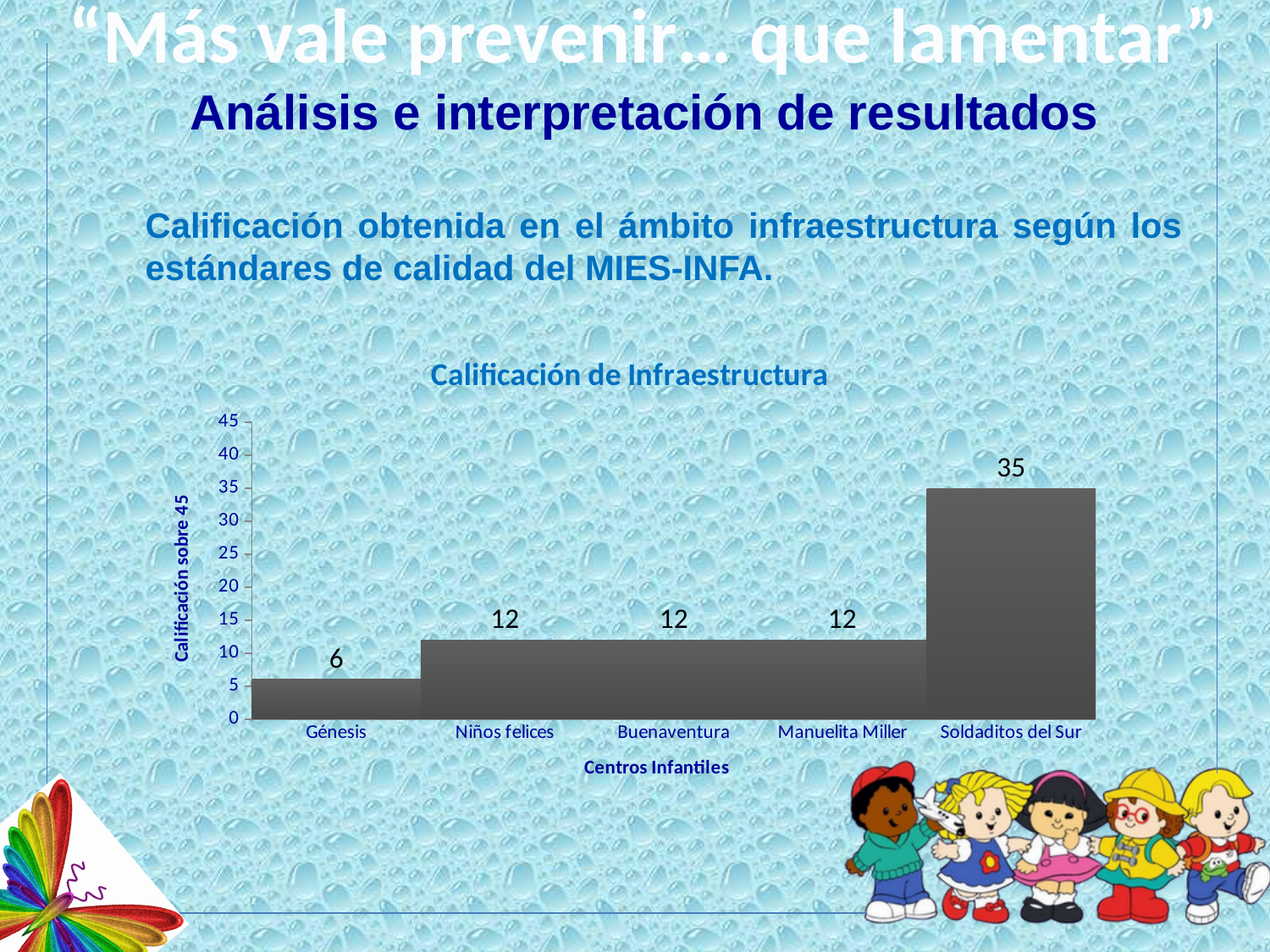
What is the value for Génesis? 6 How many centros infantiles are shown on the x axis? 5 Which is larger, the value for Manuelita Miller or the value for Génesis? Manuelita Miller What is the title of the chart? Calificación de Infraestructura What is the difference between the values for Niños felices and Génesis? 6 Which centro infantil has the lowest calificación? Génesis What is the value for Soldaditos del Sur? 35 Which centro infantil has the highest calificación? Soldaditos del Sur Is the value for Soldaditos del Sur greater or less than 30? greater What is the difference between the values for Soldaditos del Sur and Génesis? 29 What is the value for Buenaventura? 12 What kind of chart is shown? bar chart